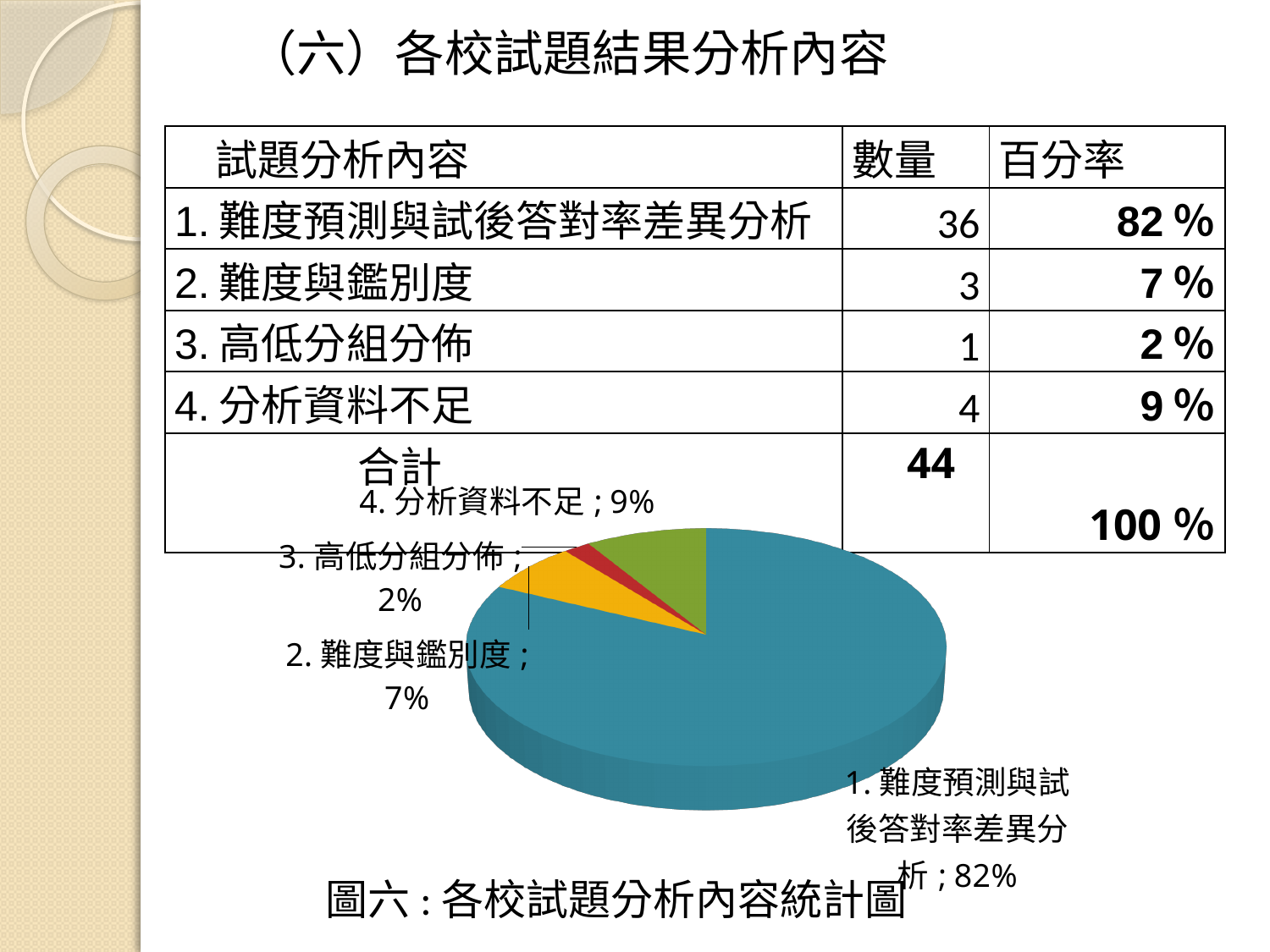
Which slice of the pie chart is the smallest? 3. 高低分組分佈 Which is larger in the pie chart: 「2. 難度與鑑別度」 or 「4. 分析資料不足」? 4. 分析資料不足 What is the difference in percentage points between 「4. 分析資料不足」 and 「2. 難度與鑑別度」? 2 Which slice of the pie chart is the largest? 1. 難度預測與試後答對率差異分析 What percentage does the slice labelled 「1. 難度預測與試後答對率差異分析」 show? 82% What kind of chart is shown on the slide? pie chart What percentage does the slice labelled 「4. 分析資料不足」 show? 9% What percentage does the slice labelled 「2. 難度與鑑別度」 show? 7% How many slices does the pie chart have? 4 What is the caption of the pie chart? 圖六：各校試題分析內容統計圖 What colour is the largest slice of the pie chart? teal blue What percentage does the slice labelled 「3. 高低分組分佈」 show? 2%